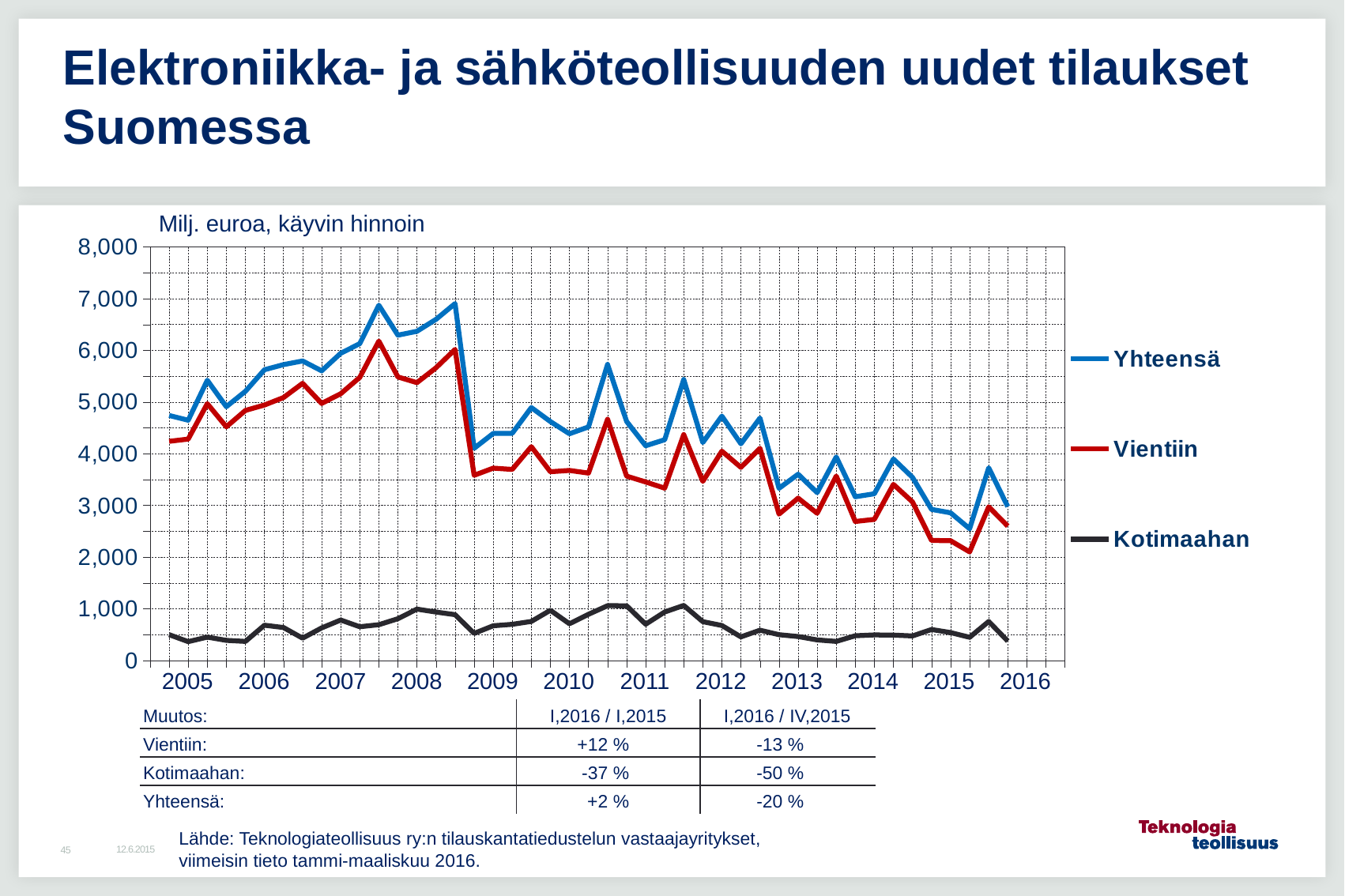
What kind of chart is shown on the slide? line chart What are the three series named in the chart legend? Yhteensä, Vientiin, Kotimaahan Is the peak value of the Yhteensä series in 2008 greater or less than 6,000? greater Which series is higher in 2012, Yhteensä or Kotimaahan? Yhteensä Which series has the lowest values throughout the chart? Kotimaahan What unit is stated above the chart's y axis? Milj. euroa, käyvin hinnoin Is the last plotted value of the Vientiin series in 2016 greater or less than 3,000? less Is the value of the Kotimaahan series ever greater or less than 2,000? less How many series does the chart legend list? 3 Does the Yhteensä series rise or fall overall from its 2008 peak to 2016? fall Which series reaches the highest value on the chart? Yhteensä